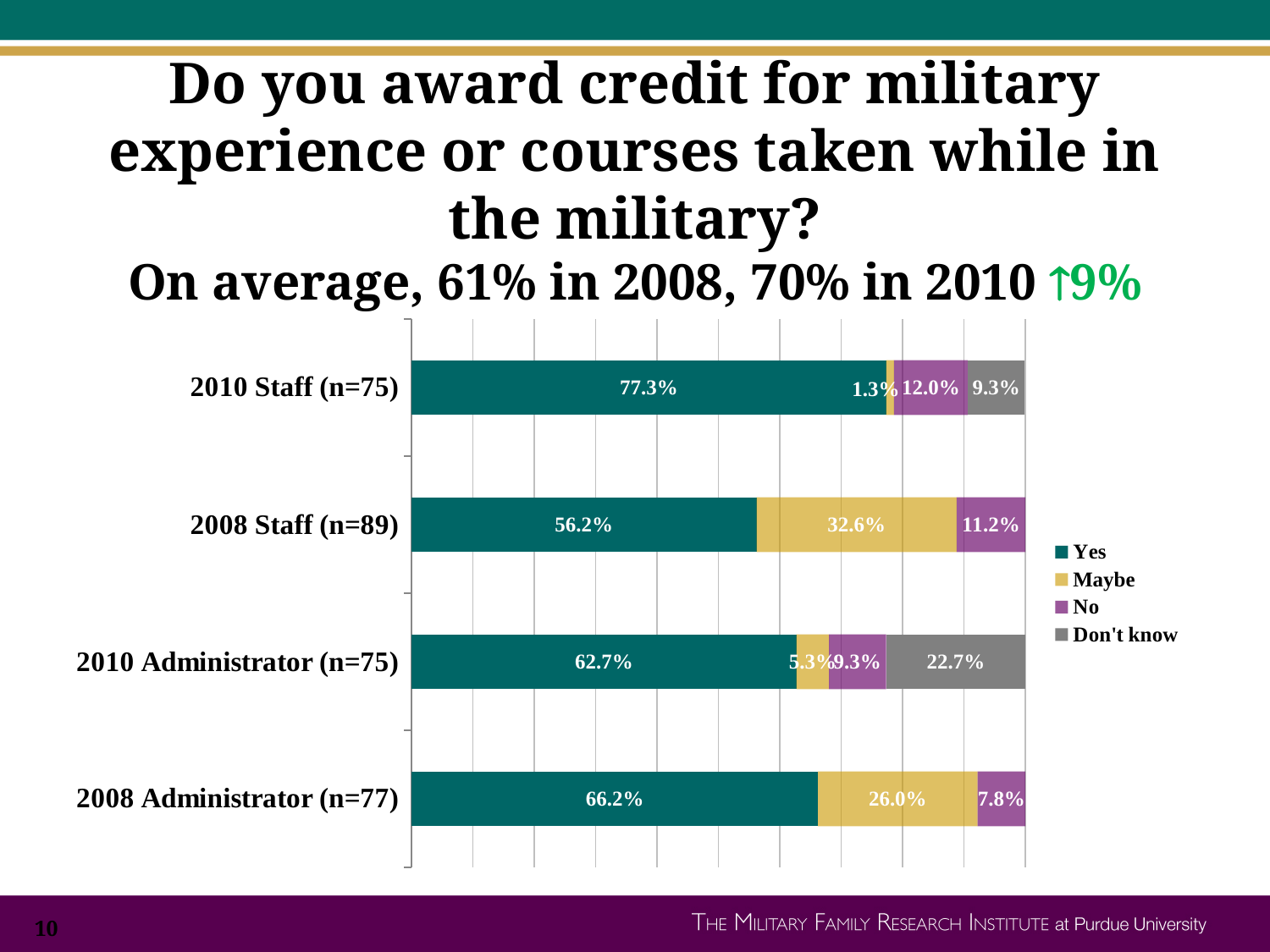
How many groups (bars) are shown in the chart? 4 What is the Maybe value for 2008 Staff (n=89)? 32.6% What is the No value for 2008 Administrator (n=77)? 7.8% What kind of chart is shown on the slide? Stacked bar chart Which has a larger Maybe value, 2008 Staff (n=89) or 2008 Administrator (n=77)? 2008 Staff (n=89) Which group has the lowest Yes percentage? 2008 Staff (n=89) What is the Don't know value for 2010 Administrator (n=75)? 22.7% How many series does the legend list? 4 Which group has the highest Yes percentage? 2010 Staff (n=75) How much higher is the Yes percentage for 2010 Staff (n=75) than for 2008 Staff (n=89)? 21.1 percentage points What percentage of 2010 Staff (n=75) answered Yes? 77.3% Which legend entry is shown in gray? Don't know